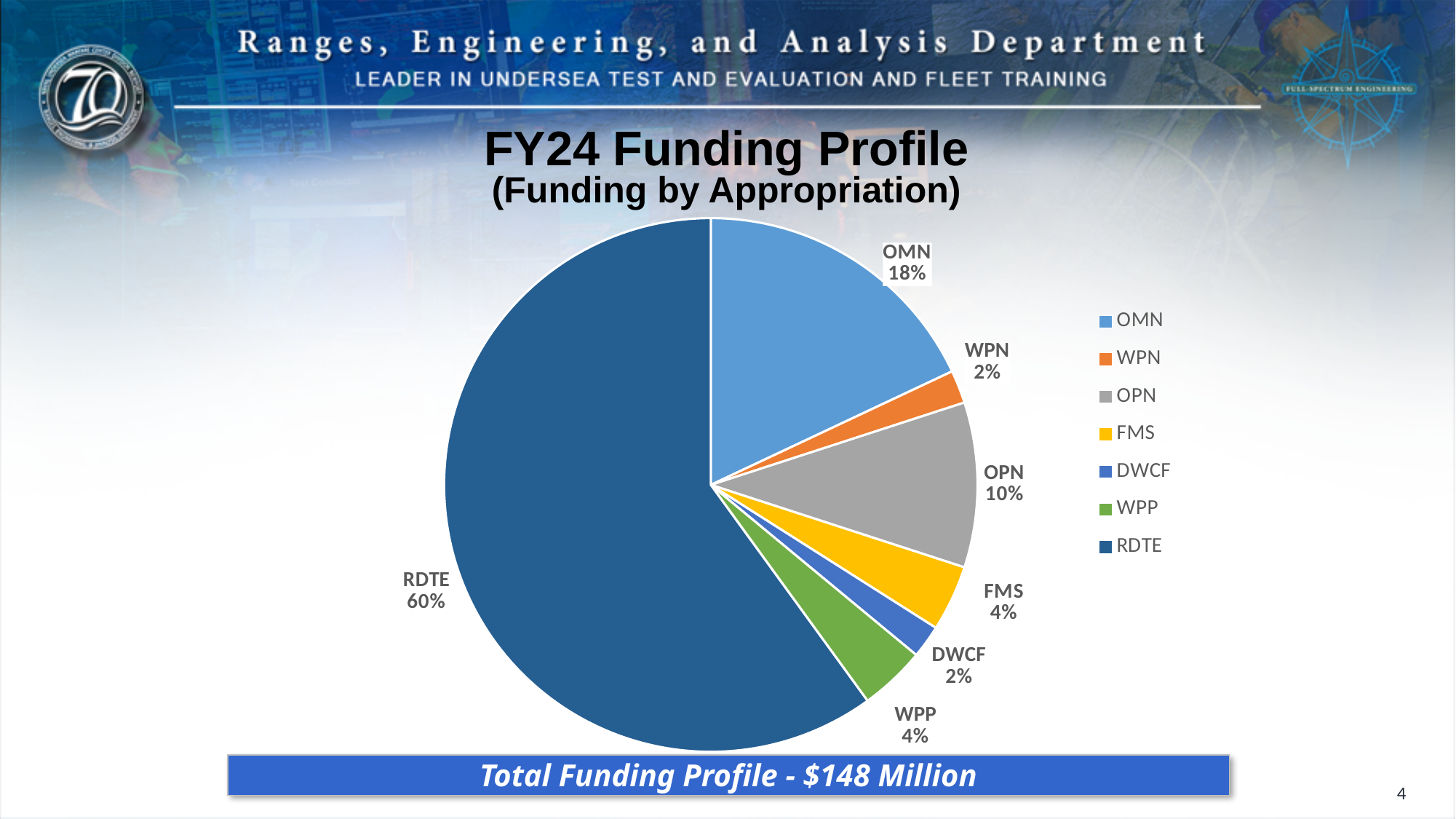
What share of FY24 funding is RDTE? 60% What share of FY24 funding is FMS? 4% How many appropriation categories does the legend list? 7 What is the total funding profile stated below the chart? $148 Million What kind of chart is shown on the slide? pie chart Which appropriation has the largest share of FY24 funding? RDTE Which has a larger share of FY24 funding, OPN or FMS? OPN What is the difference in percentage points between the RDTE share and the OMN share? 42 What colour is the RDTE slice in the pie chart? dark blue What share of FY24 funding is OPN? 10% Which has a larger share of FY24 funding, OMN or WPP? OMN